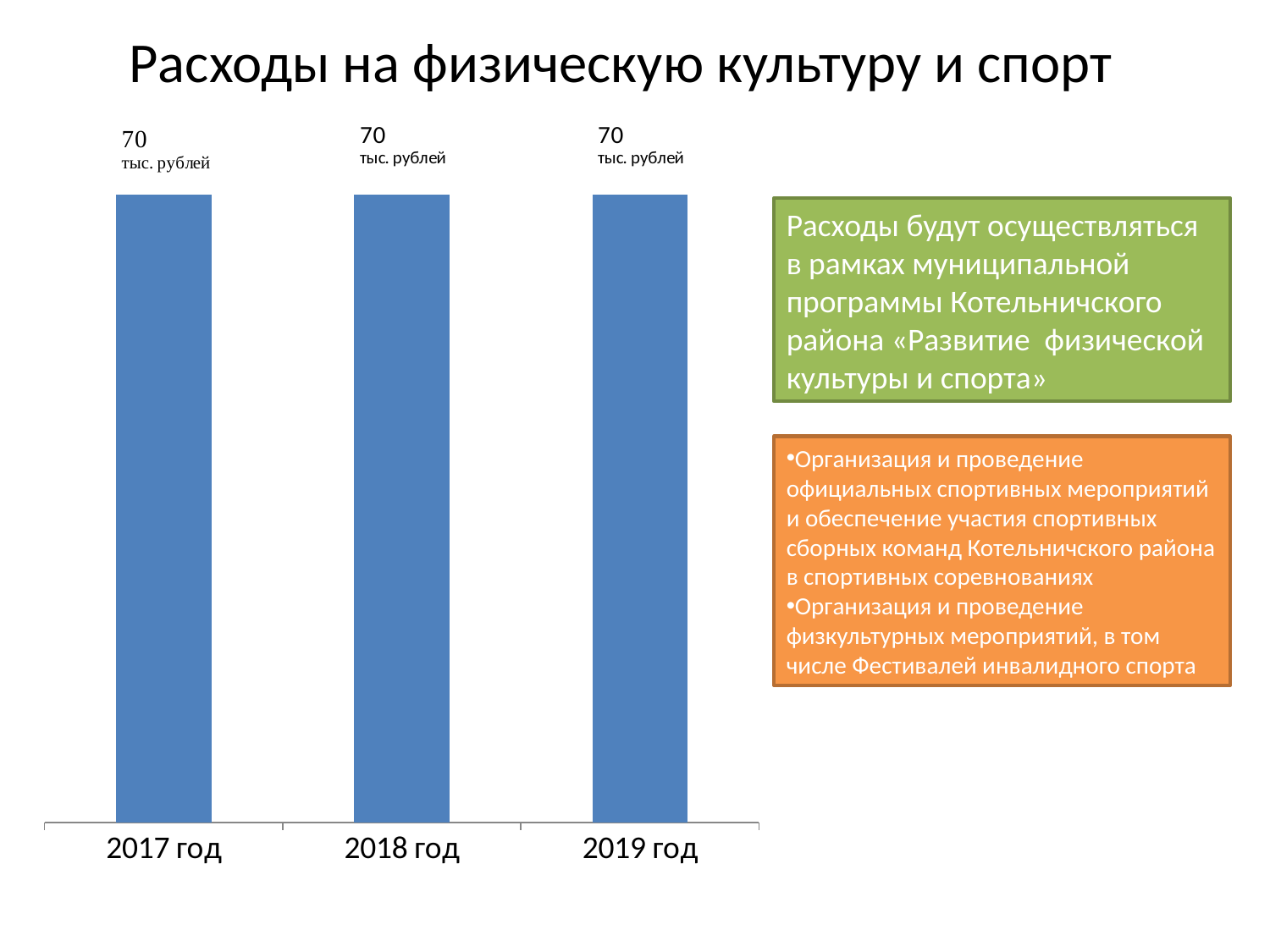
What is the value for 2018 год? 70 тыс. рублей What kind of chart is shown on the slide? bar chart What is the title of the slide containing the chart? Расходы на физическую культуру и спорт How many categories (years) are shown on the chart? 3 What is the difference between the values for 2018 год and 2017 год? 0 What is the value for 2017 год? 70 тыс. рублей What colour are the bars in the chart? blue What is the difference between the values for 2019 год and 2017 год? 0 Do the values rise, fall or stay the same from 2017 год to 2019 год? stay the same In what unit are the values on the chart expressed? тыс. рублей What is the value for 2019 год? 70 тыс. рублей